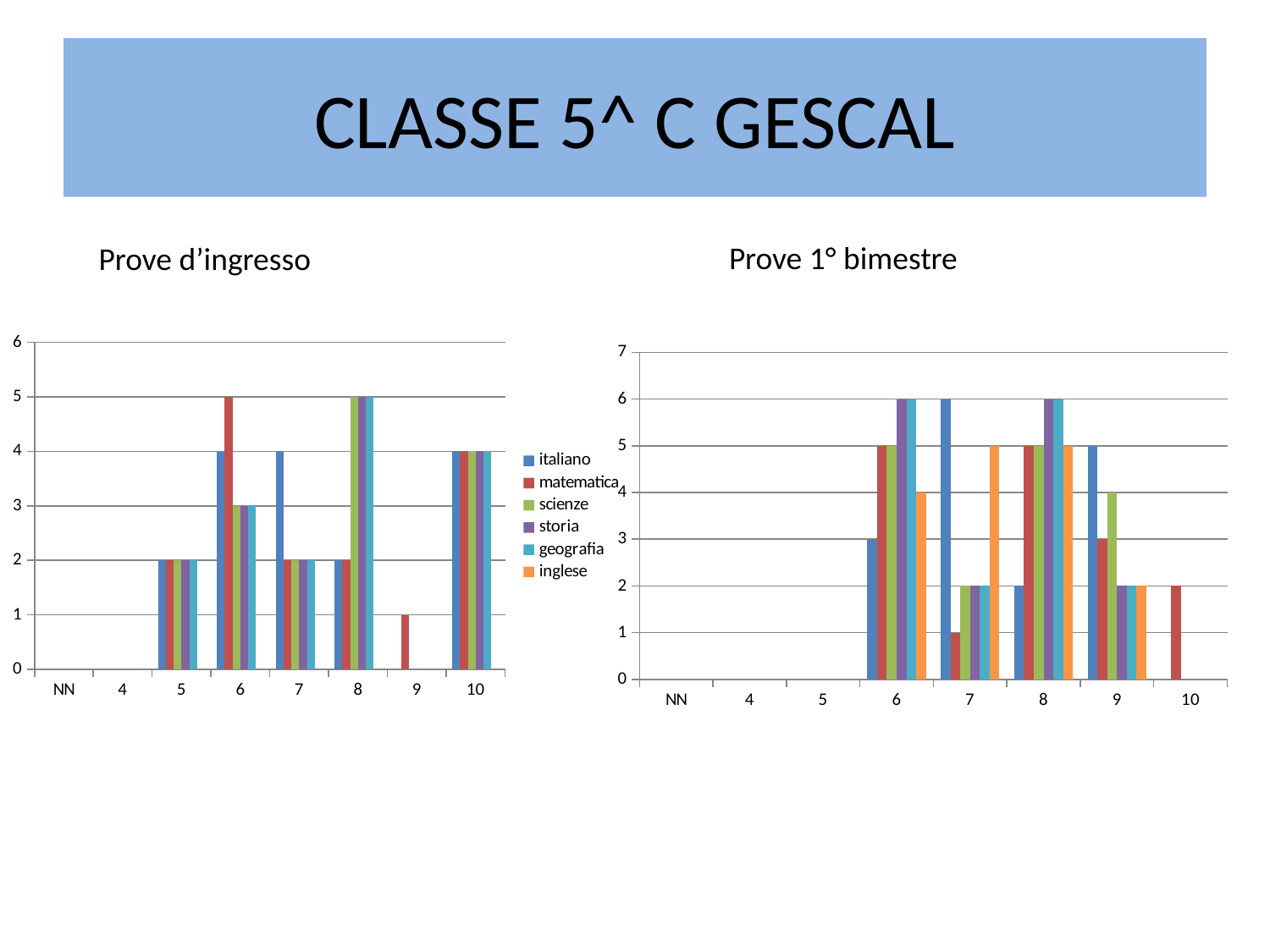
In the "Prove 1° bimestre" chart, is the value for storia at category 8 greater or less than 4? greater In the "Prove 1° bimestre" chart, which series has the lowest value at category 7? matematica In the "Prove d'ingresso" chart, what is the difference between scienze and italiano at category 8? 3 In the "Prove d'ingresso" chart, what is the value for italiano at category 7? 4 In the "Prove d'ingresso" chart, what is the value for matematica at category 6? 5 In the "Prove d'ingresso" chart, which series has the highest value at category 9? matematica How many categories are on the x axis of the "Prove 1° bimestre" chart? 8 In the "Prove 1° bimestre" chart, what is the value for inglese at category 6? 4 In the "Prove 1° bimestre" chart, which is larger at category 9: italiano or scienze? italiano What kind of chart is the "Prove d'ingresso" chart? bar chart In the "Prove 1° bimestre" chart, what is the value for italiano at category 7? 6 How many series does the legend list? 6